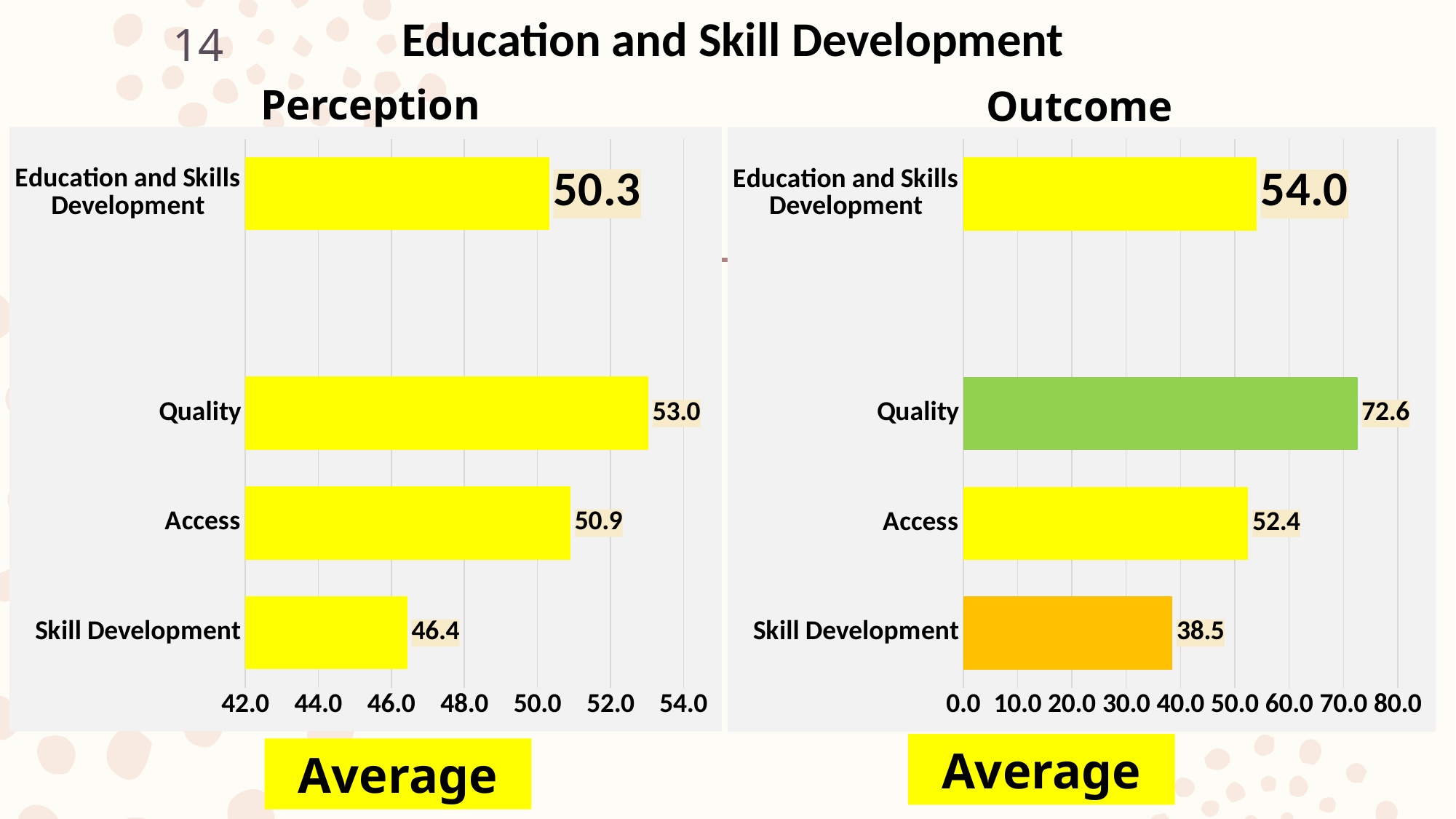
In the Perception chart, what is the value for Quality? 53.0 In the Outcome chart, what is the value for Skill Development? 38.5 How many bars are shown in the Perception chart? 4 In the Perception chart, which is larger, the value for Access or the value for Education and Skills Development? Access In the Outcome chart, what is the value for Education and Skills Development? 54.0 What type of chart is the Outcome chart? bar chart In the Outcome chart, what colour is the Skill Development bar? orange In the Outcome chart, which category has the highest value? Quality In the Perception chart, what is the difference between the values for Access and Skill Development? 4.5 In the Outcome chart, is the value for Access greater or less than 50.0? greater In the Outcome chart, what is the difference between the values for Quality and Skill Development? 34.1 In the Perception chart, which category has the lowest value? Skill Development